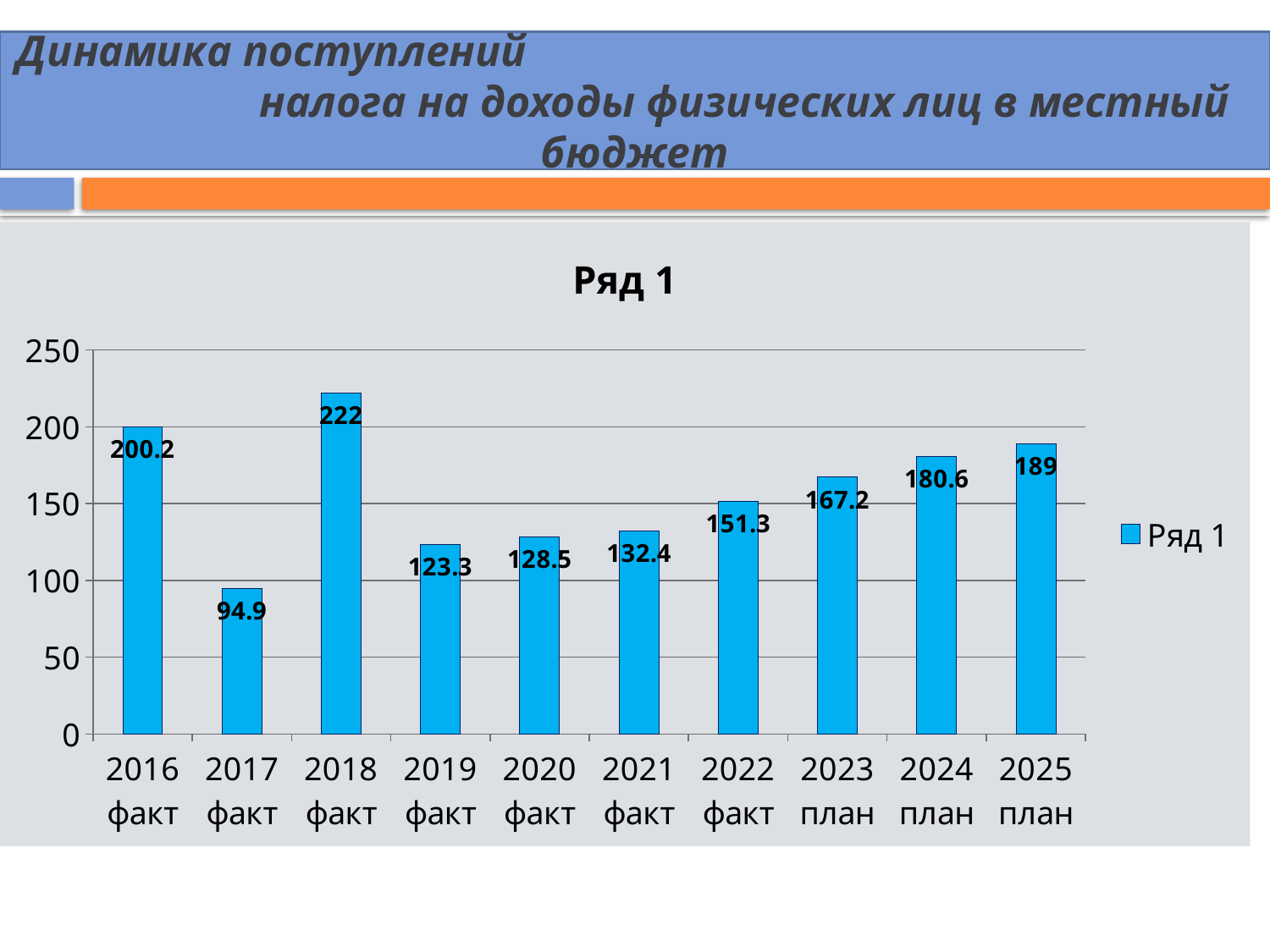
Is the value for 2024 план greater or less than 150? greater Which is larger, the value for 2023 план or the value for 2022 факт? 2023 план How many categories are shown on the x axis? 10 Which category has the highest value? 2018 факт Do the values rise or fall from 2019 факт to 2025 план? rise What is the difference between the values for 2016 факт and 2017 факт? 105.3 What is the value for 2017 факт? 94.9 How many series does the legend list? 1 What kind of chart is shown on the slide? bar chart What is the value for 2025 план? 189 What is the value for 2018 факт? 222 Which category has the lowest value? 2017 факт